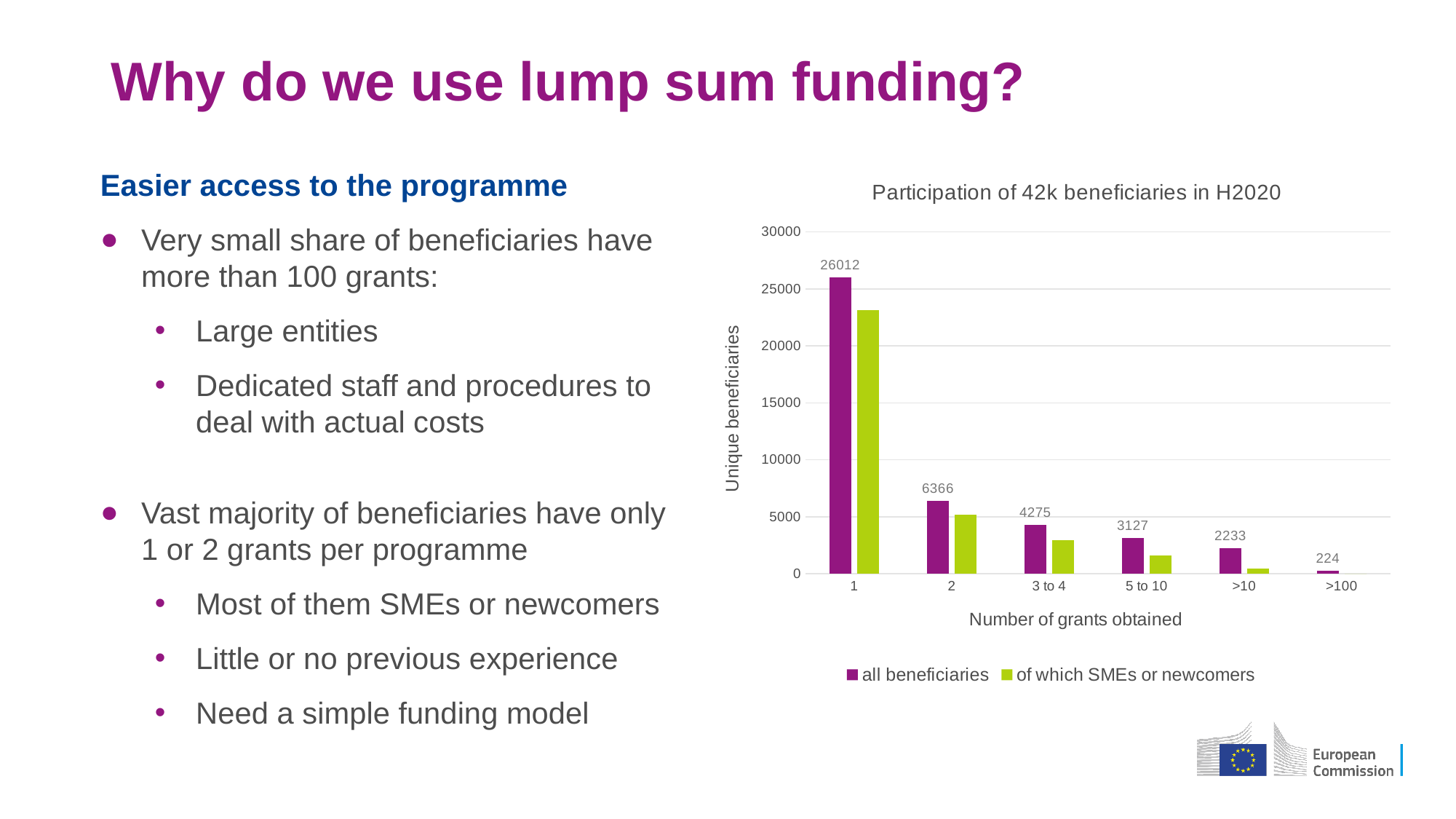
Which category has the highest value for 'all beneficiaries'? 1 How many categories are shown on the x axis? 6 What is the difference between the 'all beneficiaries' values for the '1' and '2' grant categories? 19646 What is the value for 'all beneficiaries' in the '1' grant category? 26012 What is the value for 'all beneficiaries' in the '2' grants category? 6366 Which category has the lowest value for 'all beneficiaries'? >100 How many series does the legend list? 2 Is the value for 'of which SMEs or newcomers' in the '1' grant category greater or less than 20000? greater Which is larger for 'all beneficiaries': the '3 to 4' category or the '5 to 10' category? 3 to 4 What is the value for 'all beneficiaries' in the '>100' grants category? 224 What kind of chart is shown on the slide? bar chart What is the title of the chart? Participation of 42k beneficiaries in H2020